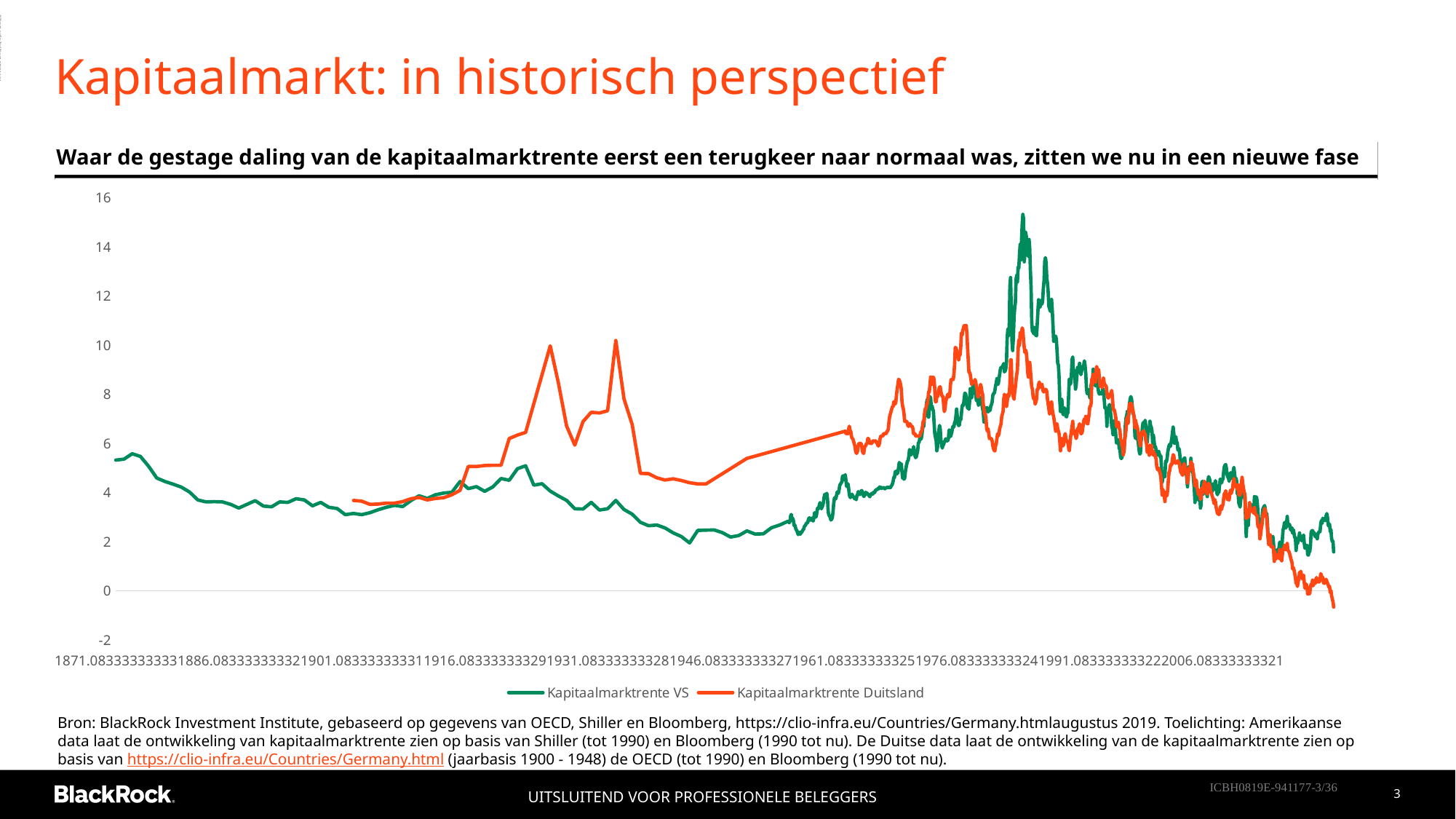
How many series does the legend list? 2 Is the highest value of Kapitaalmarktrente Duitsland greater or less than 12? less Is the value of Kapitaalmarktrente Duitsland at its first peak near the middle of the chart greater or less than 8? greater Is the highest value of Kapitaalmarktrente VS greater or less than 14? greater What kind of chart is shown on the slide? line chart What colour is the Kapitaalmarktrente VS line? green At the right end of the chart, which series is higher, Kapitaalmarktrente VS or Kapitaalmarktrente Duitsland? Kapitaalmarktrente VS Which series reaches the higher peak, Kapitaalmarktrente VS or Kapitaalmarktrente Duitsland? Kapitaalmarktrente VS What are the two series named in the legend? Kapitaalmarktrente VS and Kapitaalmarktrente Duitsland After their peaks in the right half of the chart, do the values of both series rise or fall towards the right end? fall